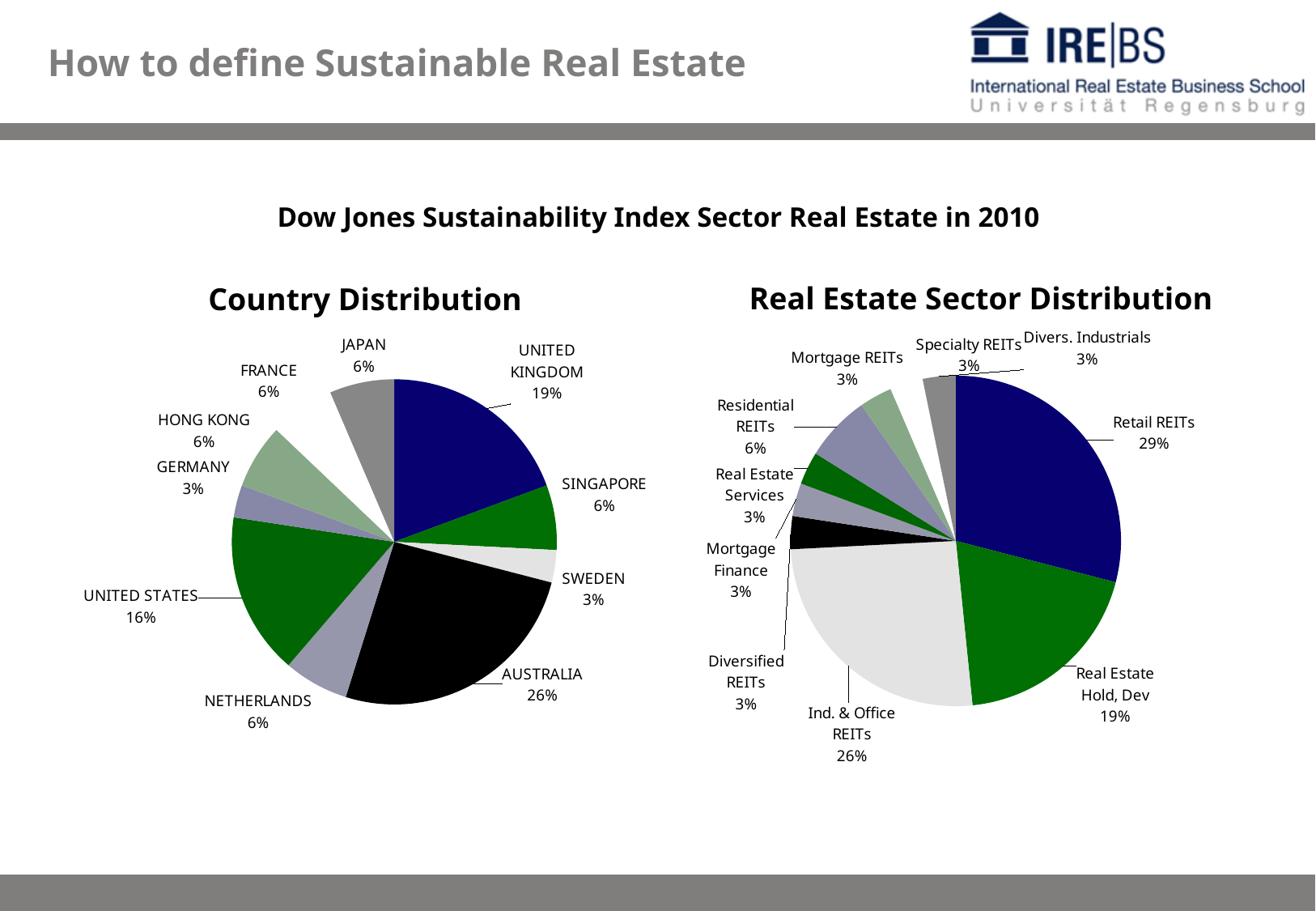
In the Real Estate Sector Distribution chart, what share do Retail REITs have? 29% In the Country Distribution chart, which country has the largest share? Australia What type of chart is the Real Estate Sector Distribution chart? Pie chart How many countries are shown in the Country Distribution chart? 10 In the Real Estate Sector Distribution chart, what is the difference between the shares of Ind. & Office REITs and Real Estate Hold, Dev? 7% In the Country Distribution chart, which is larger, the share of the United Kingdom or the share of the United States? United Kingdom In the Real Estate Sector Distribution chart, which sector has the largest share? Retail REITs In the Country Distribution chart, what share does the United States have? 16% What is the title shown above both charts on the slide? Dow Jones Sustainability Index Sector Real Estate in 2010 In the Country Distribution chart, what is the difference between the shares of the United Kingdom and Sweden? 16% In the Real Estate Sector Distribution chart, what share do Residential REITs have? 6% In the Country Distribution chart, what share does Australia have? 26%